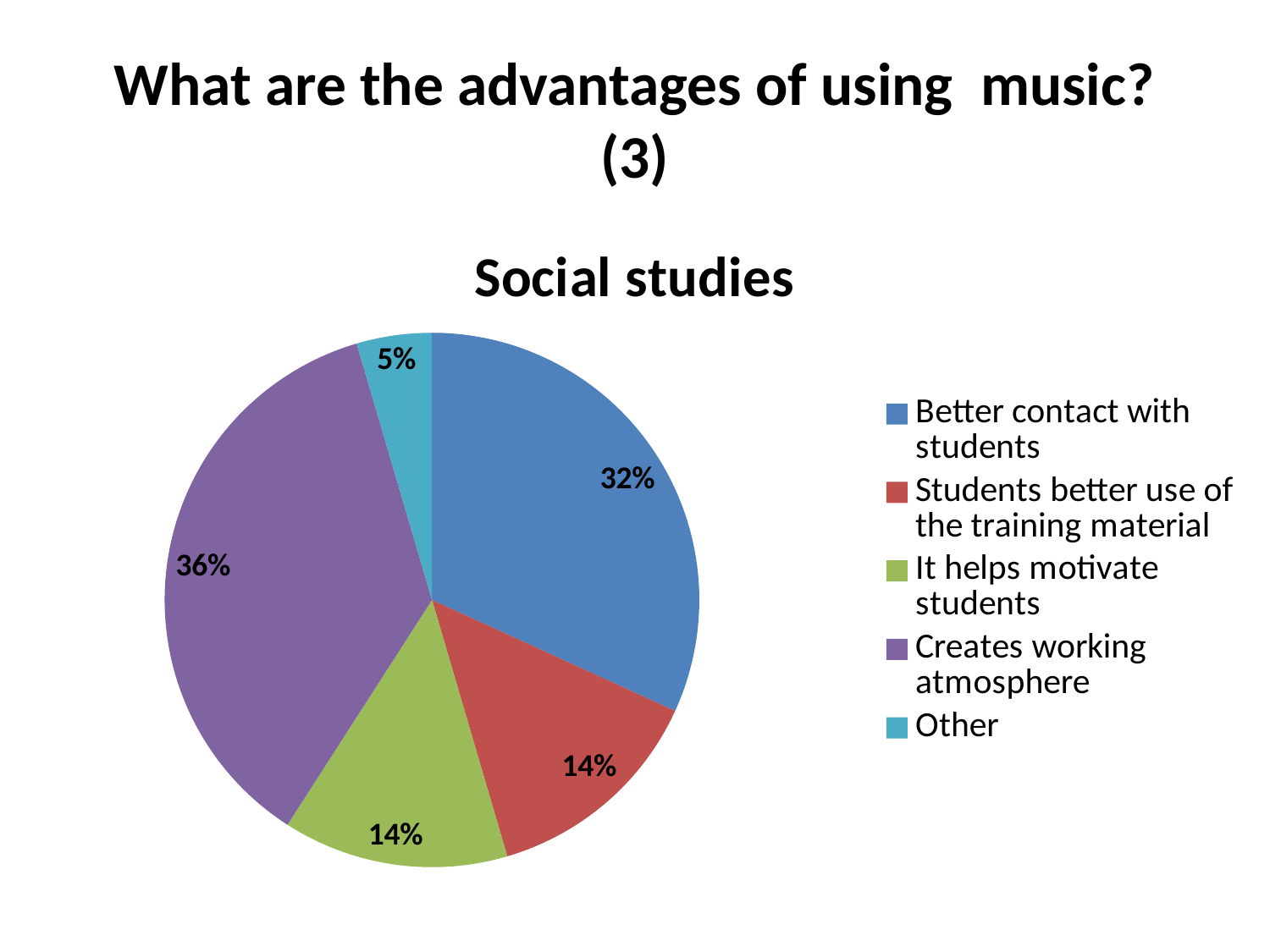
What is the title of the chart? Social studies What share of the pie is labelled 'Other'? 5% What share of the pie is labelled 'Creates working atmosphere'? 36% What share of the pie is labelled 'Better contact with students'? 32% What is the difference in percentage points between 'Creates working atmosphere' and 'Better contact with students'? 4 What colour is the slice for 'Creates working atmosphere'? purple What type of chart is shown on the slide? pie chart How many categories does the legend list? 5 Which category has the smallest slice of the pie? Other Which is larger: the slice for 'Better contact with students' or the slice for 'Students better use of the training material'? Better contact with students Which category has the largest slice of the pie? Creates working atmosphere